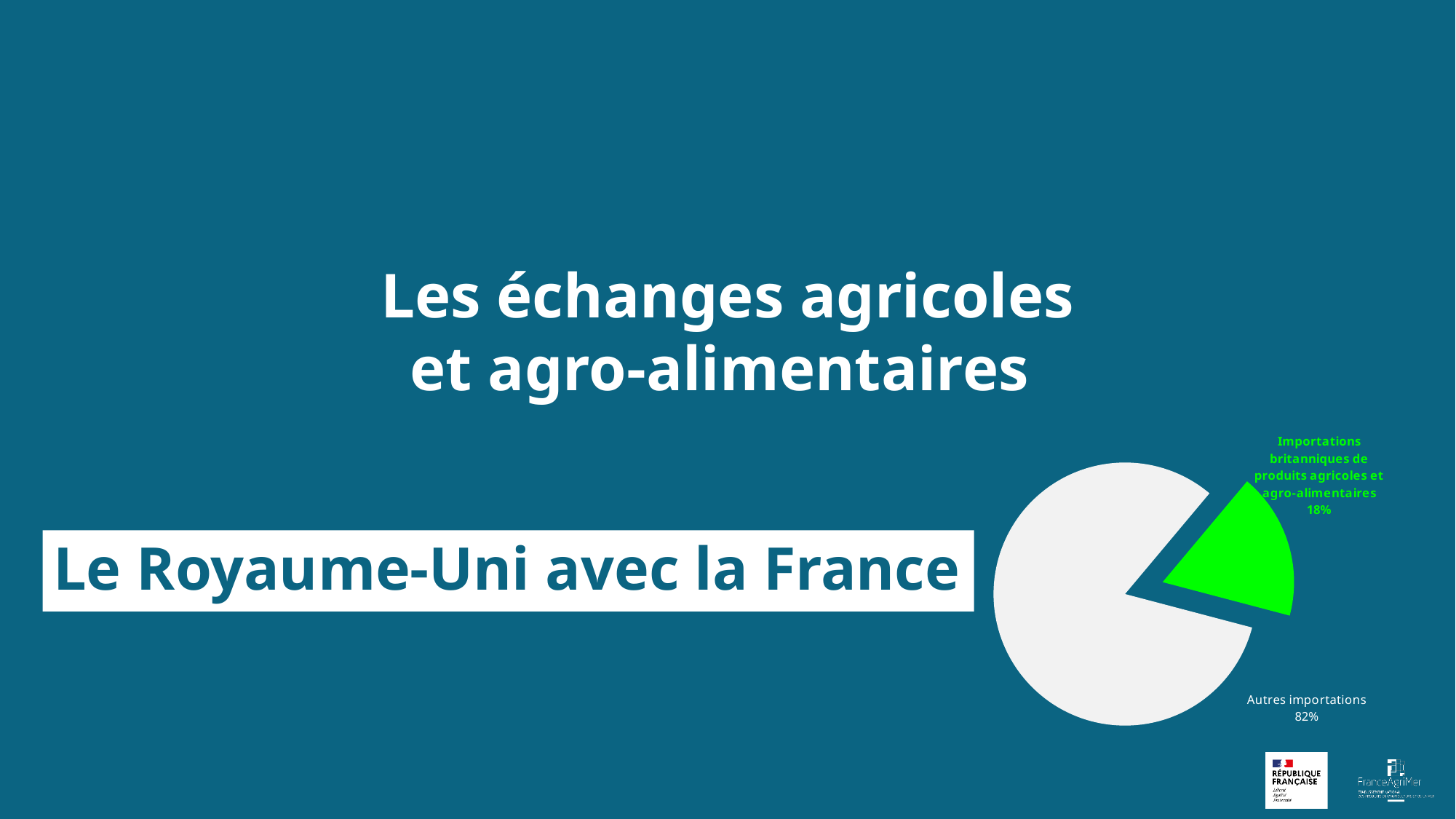
What colour is the slice for 'Autres importations'? white Which slice of the pie is the smallest? Importations britanniques de produits agricoles et agro-alimentaires What colour is the slice for 'Importations britanniques de produits agricoles et agro-alimentaires'? green How many slices does the pie chart have? 2 What kind of chart is shown on the slide? pie chart Which is larger: 'Autres importations' or 'Importations britanniques de produits agricoles et agro-alimentaires'? Autres importations What share of the pie is labelled 'Importations britanniques de produits agricoles et agro-alimentaires'? 18% What share of the pie is labelled 'Autres importations'? 82% What is the total of the two pie slice percentages? 100% What is the difference in percentage points between 'Autres importations' and 'Importations britanniques de produits agricoles et agro-alimentaires'? 64 Which slice of the pie is the largest? Autres importations